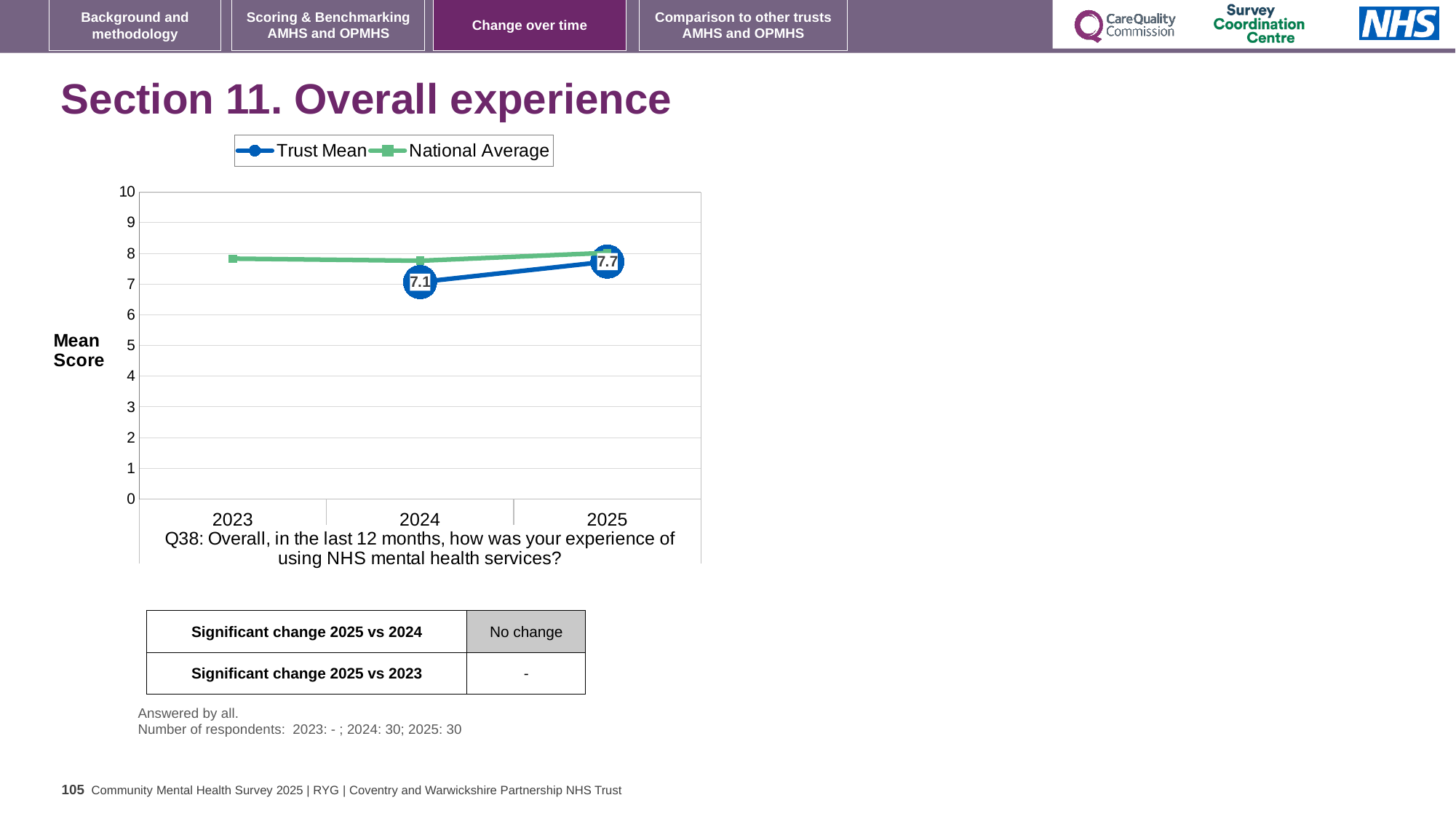
Is the National Average value for 2023 greater or less than 7? greater How many series does the legend list? 2 Does the Trust Mean rise or fall from 2024 to 2025? rise By how much did the Trust Mean score change from 2024 to 2025? 0.6 What is the Trust Mean score for 2025? 7.7 What is the Trust Mean score for 2024? 7.1 What is the label on the y axis of the chart? Mean Score What kind of chart is shown on the slide? line chart Which year has the higher Trust Mean score, 2024 or 2025? 2025 How many years are shown on the x axis? 3 What are the two series named in the legend? Trust Mean and National Average In 2024, which series has the higher value, Trust Mean or National Average? National Average